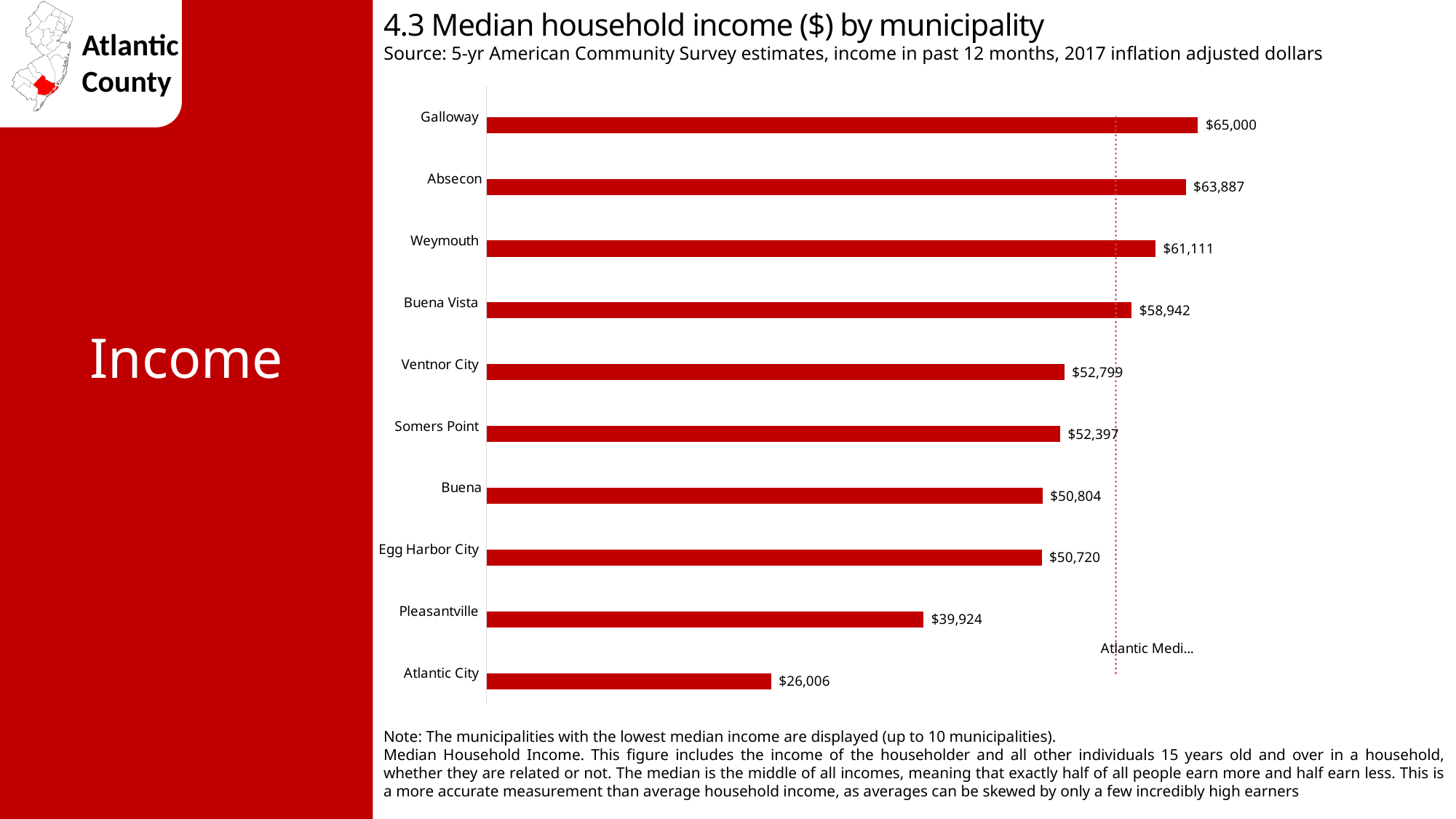
Which municipality has the lowest median household income shown on the chart? Atlantic City What type of chart is used to show median household income by municipality? Bar chart What is the median household income for Galloway? $65,000 Which has a higher median household income, Pleasantville or Egg Harbor City? Egg Harbor City What is the median household income for Buena Vista? $58,942 Which municipality has the highest median household income shown on the chart? Galloway What is the median household income for Atlantic City? $26,006 What is the title of the chart? 4.3 Median household income ($) by municipality How many municipalities are shown on the chart? 10 What is the difference in median household income between Galloway and Atlantic City? $38,994 What is the median household income for Pleasantville? $39,924 What is the difference in median household income between Absecon and Weymouth? $2,776